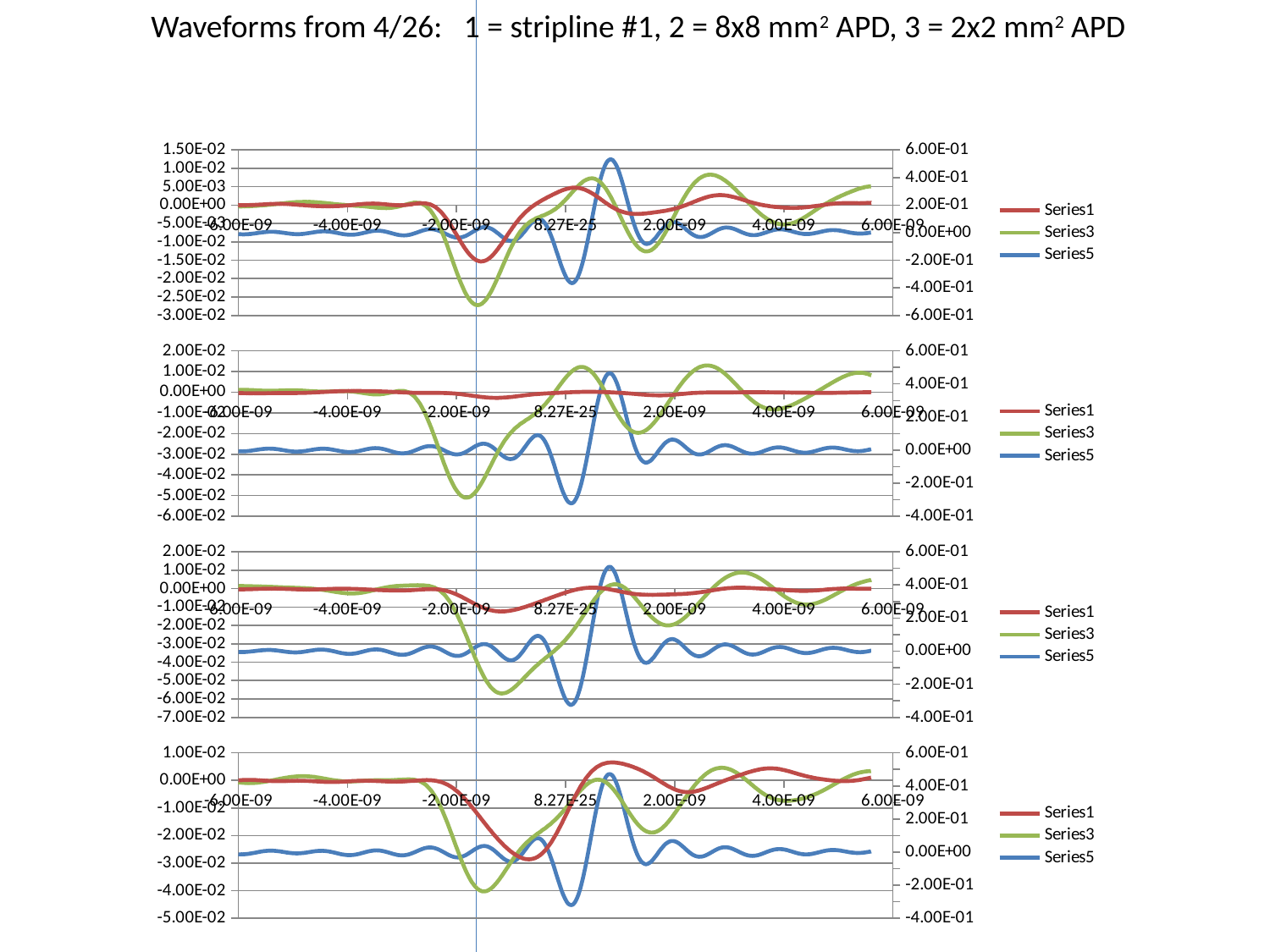
How many charts are shown on the slide? 4 In the top chart, which series names appear in the legend? Series1, Series3, Series5 In the third chart from the top, is the peak value of Series5 (blue line, right axis) greater or less than 4.00E-01? greater What kind of chart is the top chart on the slide? line chart In the second chart from the top, is the minimum value of Series3 (green line, left axis) greater or less than -4.00E-02? less In the third chart from the top, is the minimum value of Series3 (green line, left axis) greater or less than -5.00E-02? less How many series does the legend of the top chart list? 3 In the bottom chart, what colour is the line for Series5? blue In the top chart, which series reaches a lower minimum on the left axis, Series1 or Series3? Series3